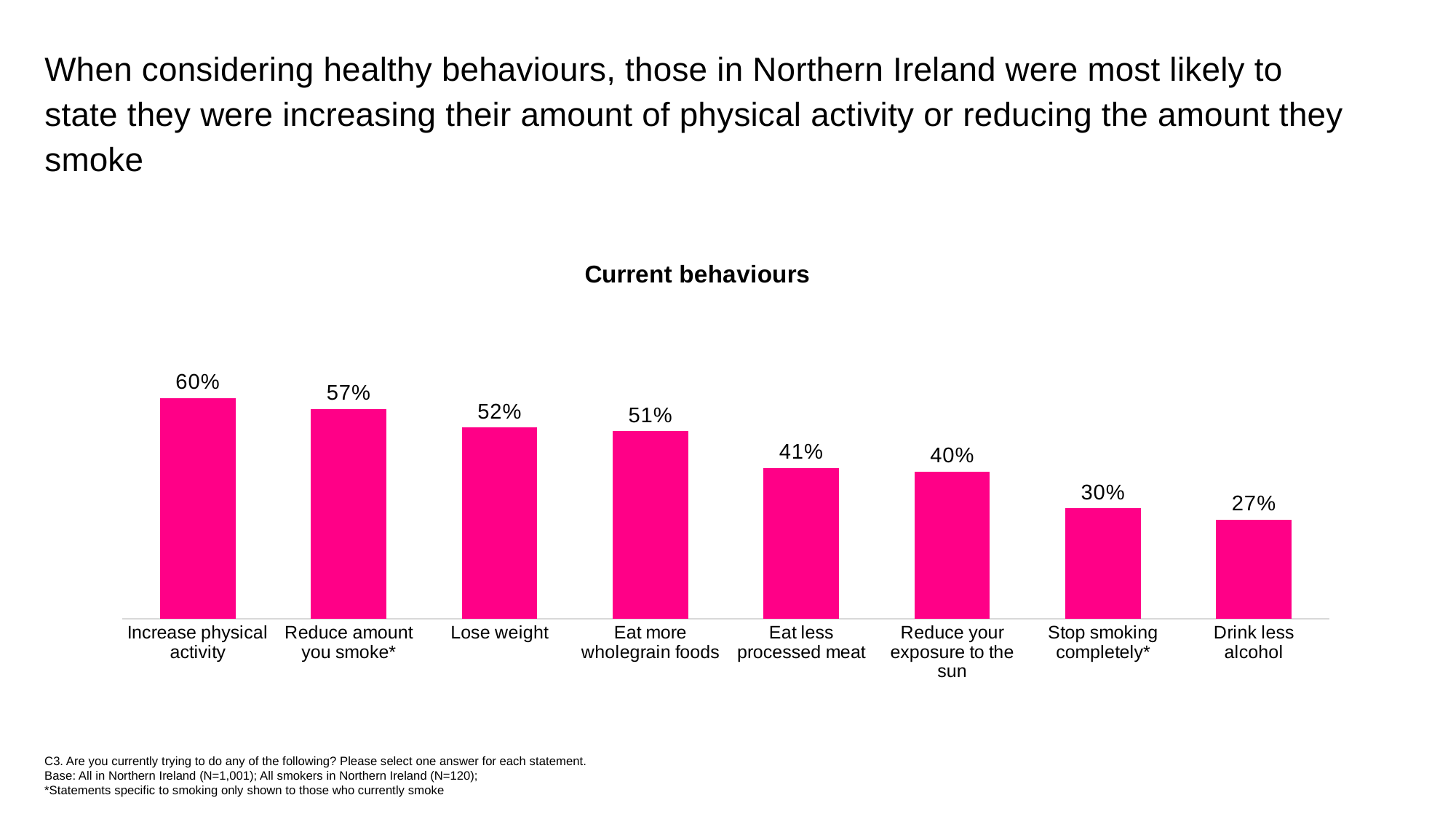
Which category has the highest value? Increase physical activity Which category has the lowest value? Drink less alcohol What colour are the bars in the chart? Pink Which is larger, the value for Reduce amount you smoke* or the value for Eat more wholegrain foods? Reduce amount you smoke* What is the value for Increase physical activity? 60% What is the difference between the values for Lose weight and Stop smoking completely*? 22% How many categories are shown in the chart? 8 What kind of chart is shown on the slide? Bar chart Do the values rise or fall from left to right across the categories? Fall What is the title of the chart? Current behaviours What is the value for Eat less processed meat? 41% What is the value for Drink less alcohol? 27%